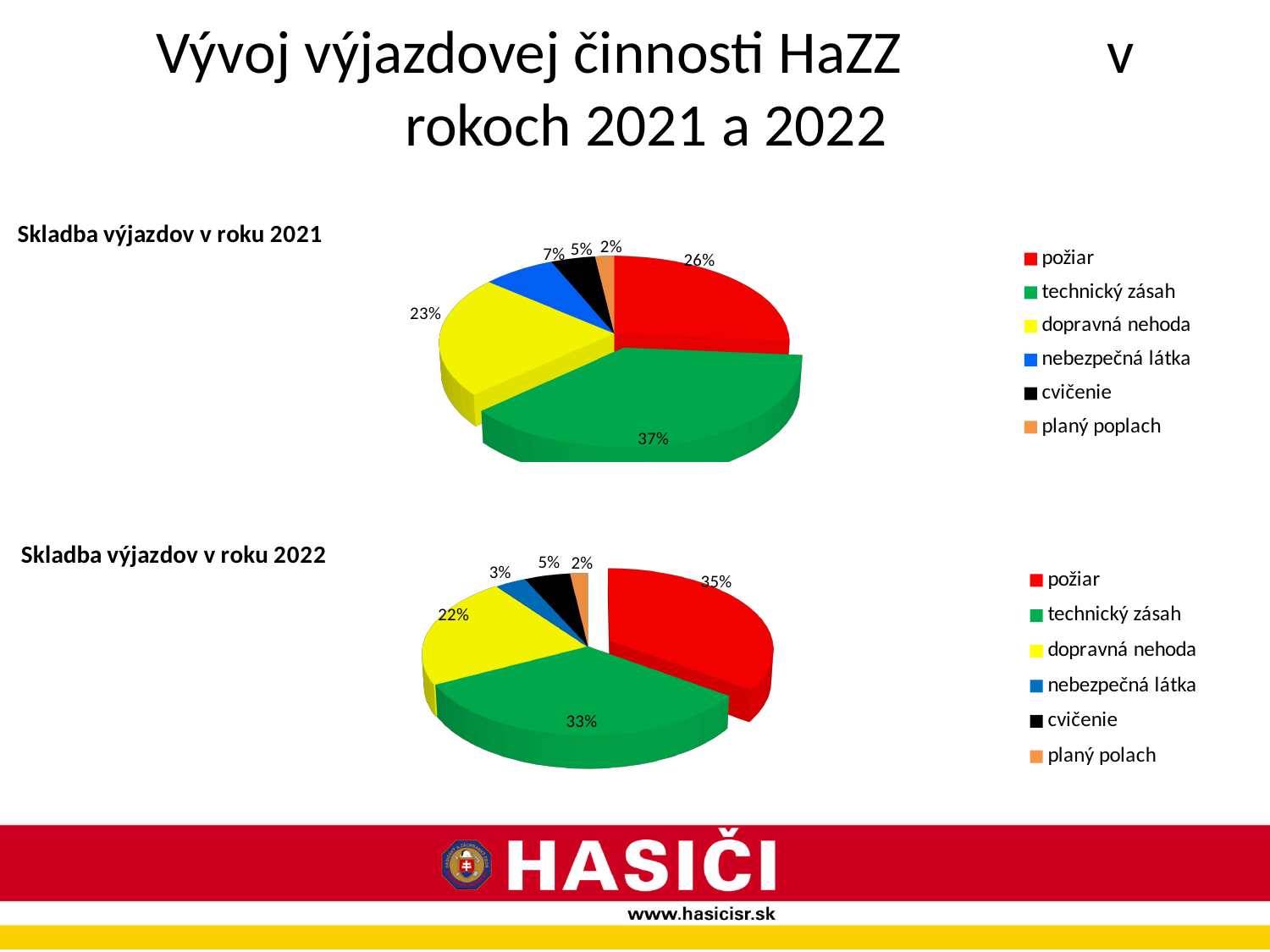
In the 'Skladba výjazdov v roku 2021' chart, what colour represents dopravná nehoda? yellow In the 'Skladba výjazdov v roku 2021' chart, what share does technický zásah have? 37% In the 'Skladba výjazdov v roku 2021' chart, which category has the smallest share? planý poplach In the 'Skladba výjazdov v roku 2021' chart, which category has the largest share? technický zásah In the 'Skladba výjazdov v roku 2021' chart, what share does požiar have? 26% In the 'Skladba výjazdov v roku 2022' chart, what is the difference between the shares of požiar and technický zásah? 2% In the 'Skladba výjazdov v roku 2021' chart, which is larger: dopravná nehoda or nebezpečná látka? dopravná nehoda What type of chart is 'Skladba výjazdov v roku 2021'? pie chart In the 'Skladba výjazdov v roku 2022' chart, which category has the largest share? požiar How many categories does the 'Skladba výjazdov v roku 2022' chart show? 6 In the 'Skladba výjazdov v roku 2022' chart, what share does požiar have? 35% In the 'Skladba výjazdov v roku 2022' chart, what share does nebezpečná látka have? 3%